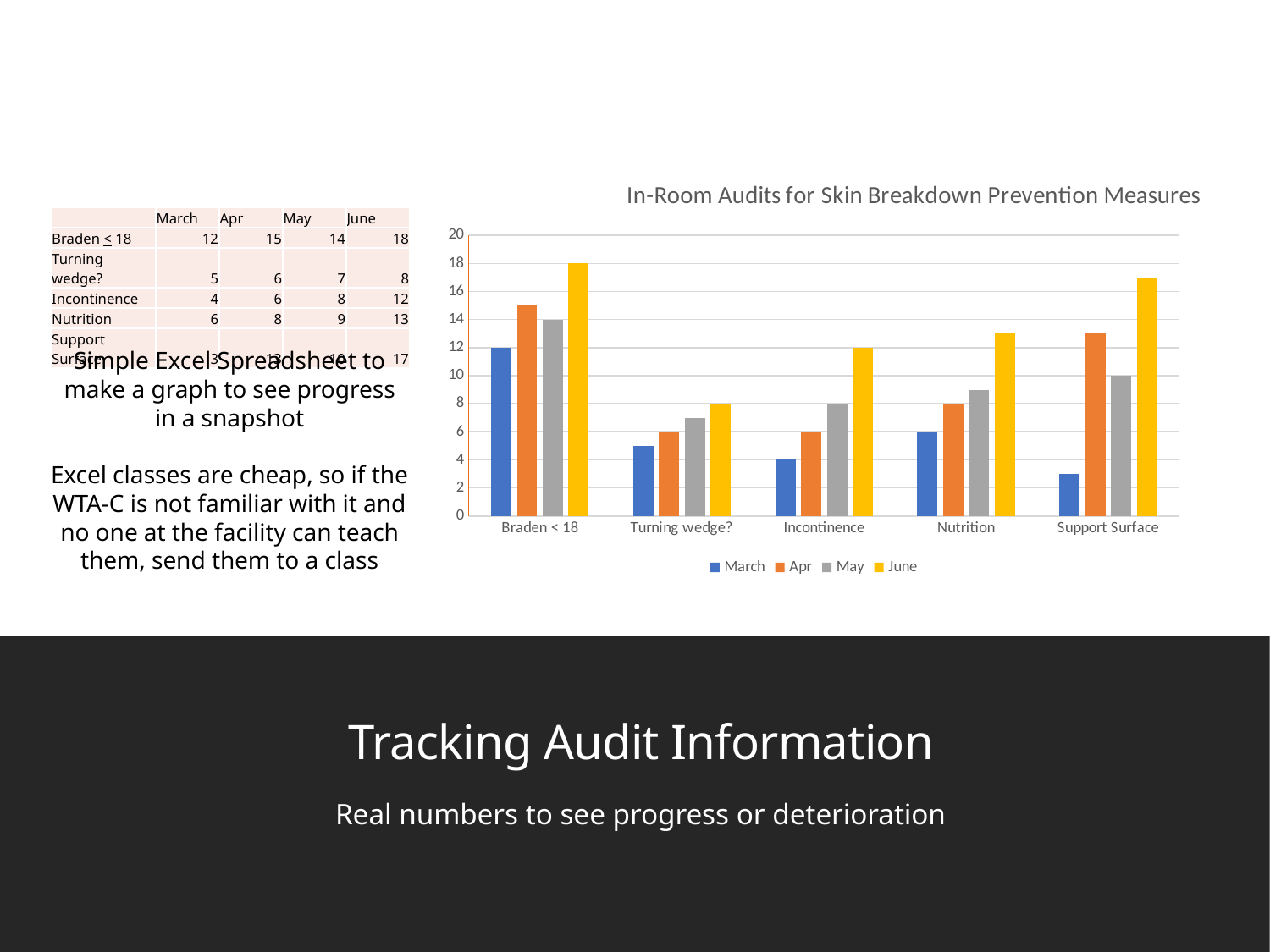
What type of chart is shown on the slide? bar chart What is the difference between the June and March values for Braden < 18? 6 What is the June value for Incontinence? 12 How many categories are shown on the x axis of the chart? 5 What is the March value for Incontinence? 4 How many series does the chart legend list? 4 Which category has the lowest March value? Support Surface Is the June value for Support Surface greater or less than 16? greater Which category has the highest June value? Braden < 18 What is the title of the chart? In-Room Audits for Skin Breakdown Prevention Measures What is the March value for Braden < 18? 12 What is the June value for Braden < 18? 18